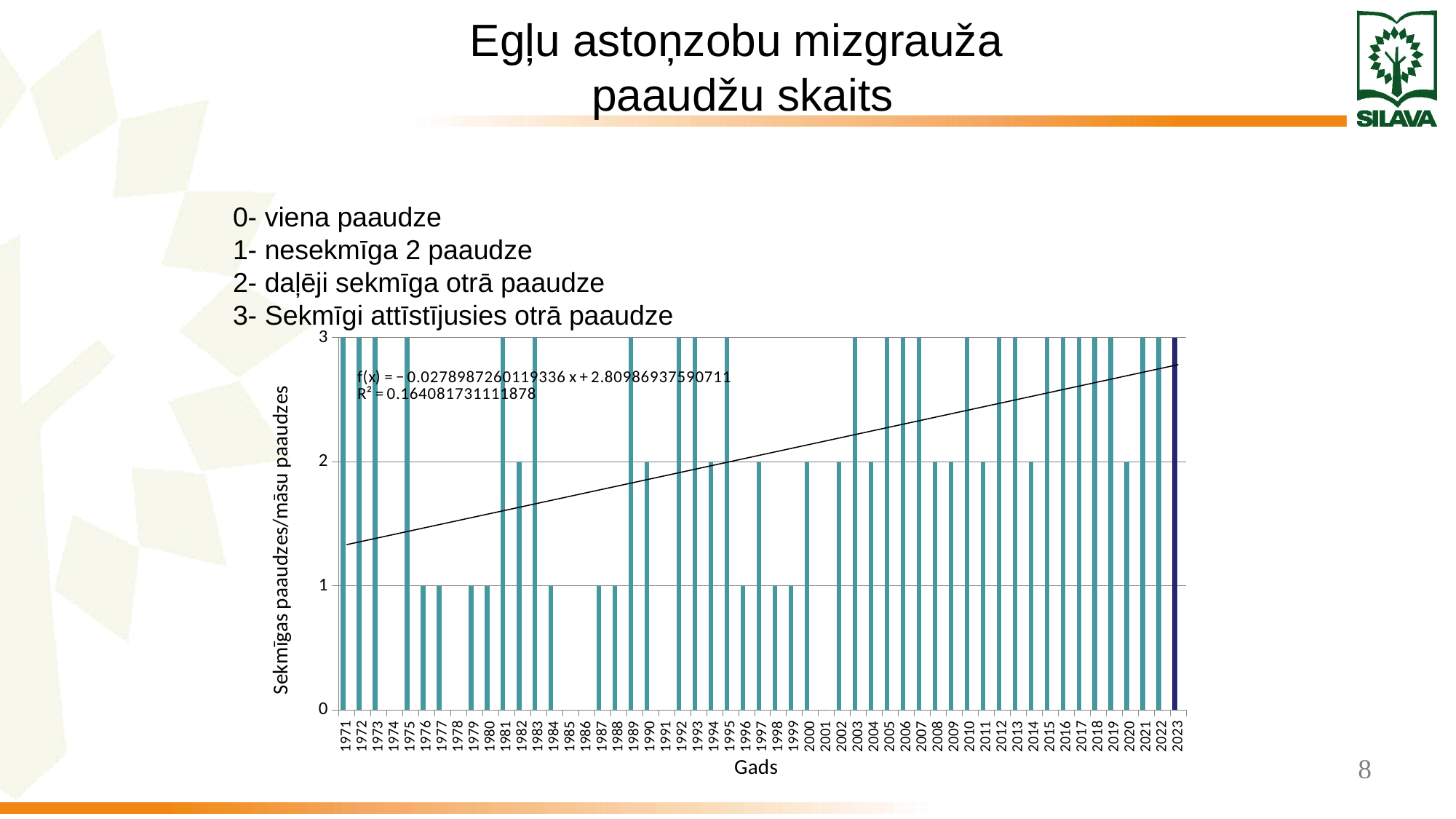
What is the value for 1974? 0 How many years are shown on the x axis? 53 What is the value for 2020? 2 What is the value for 1982? 2 What is the value for 1976? 1 What is the difference between the values for 1981 and 1982? 1 What is the title of the x axis? Gads Which year's bar is coloured dark blue instead of teal? 2023 Which is larger, the value for 1990 or the value for 1991? 1990 Does the fitted trend line rise or fall from left to right across the years? rises What is the value for 2023? 3 What kind of chart is shown on the slide? bar chart